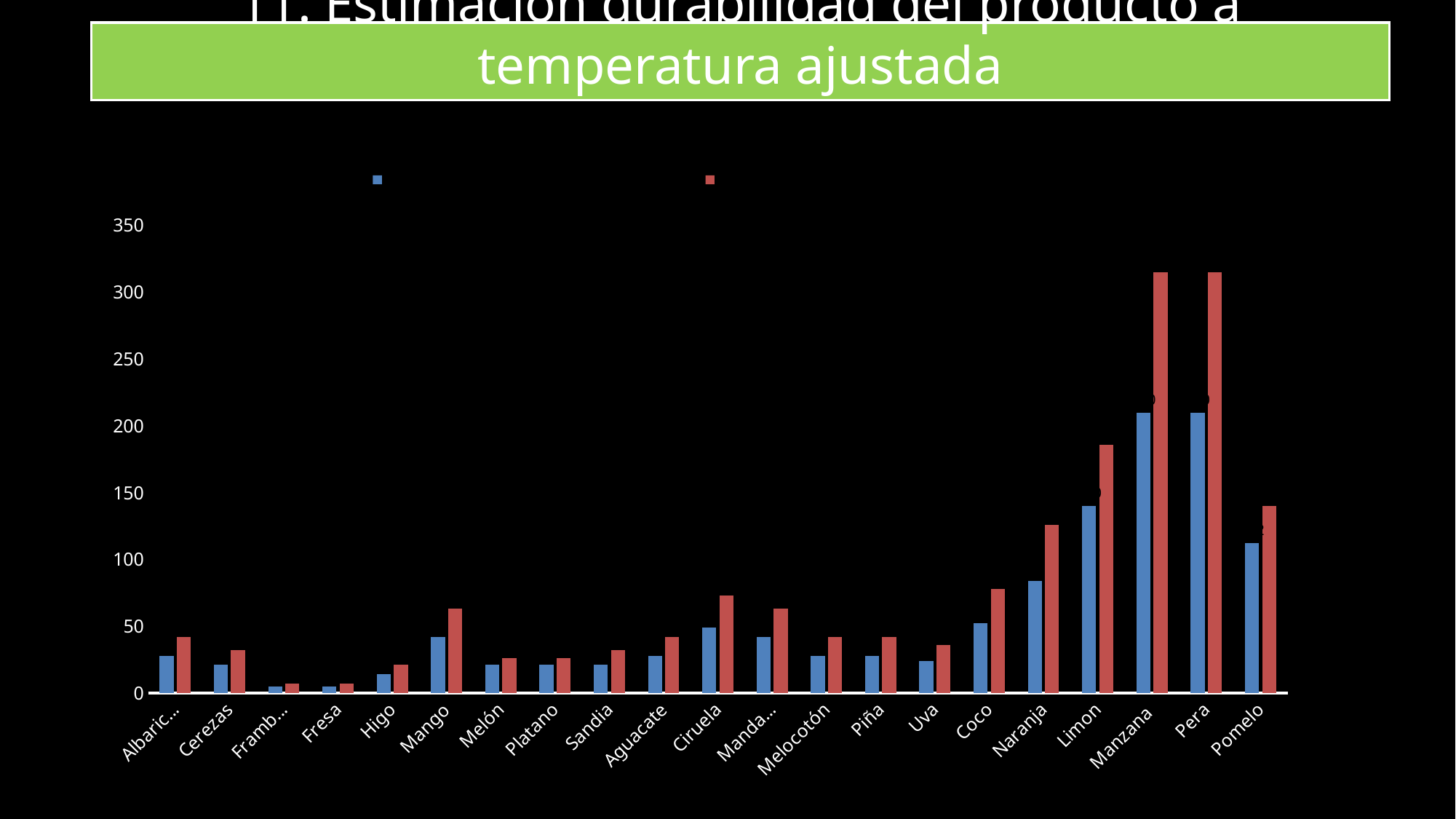
Which has the taller blue bar, Limon or Naranja? Limon For Manzana, which bar is taller, the blue one or the red one? the red one Which has the taller red bar, Mango or Melón? Mango Is the red bar for Limon greater or less than 200? less How many fruit categories are shown on the x axis? 21 Is the red bar for Naranja greater or less than 100? greater Is the blue bar for Mango greater or less than 50? less Do the red bars rise or fall from Coco to Pera? rise How many series does the chart plot? 2 What kind of chart is shown on the slide? bar chart